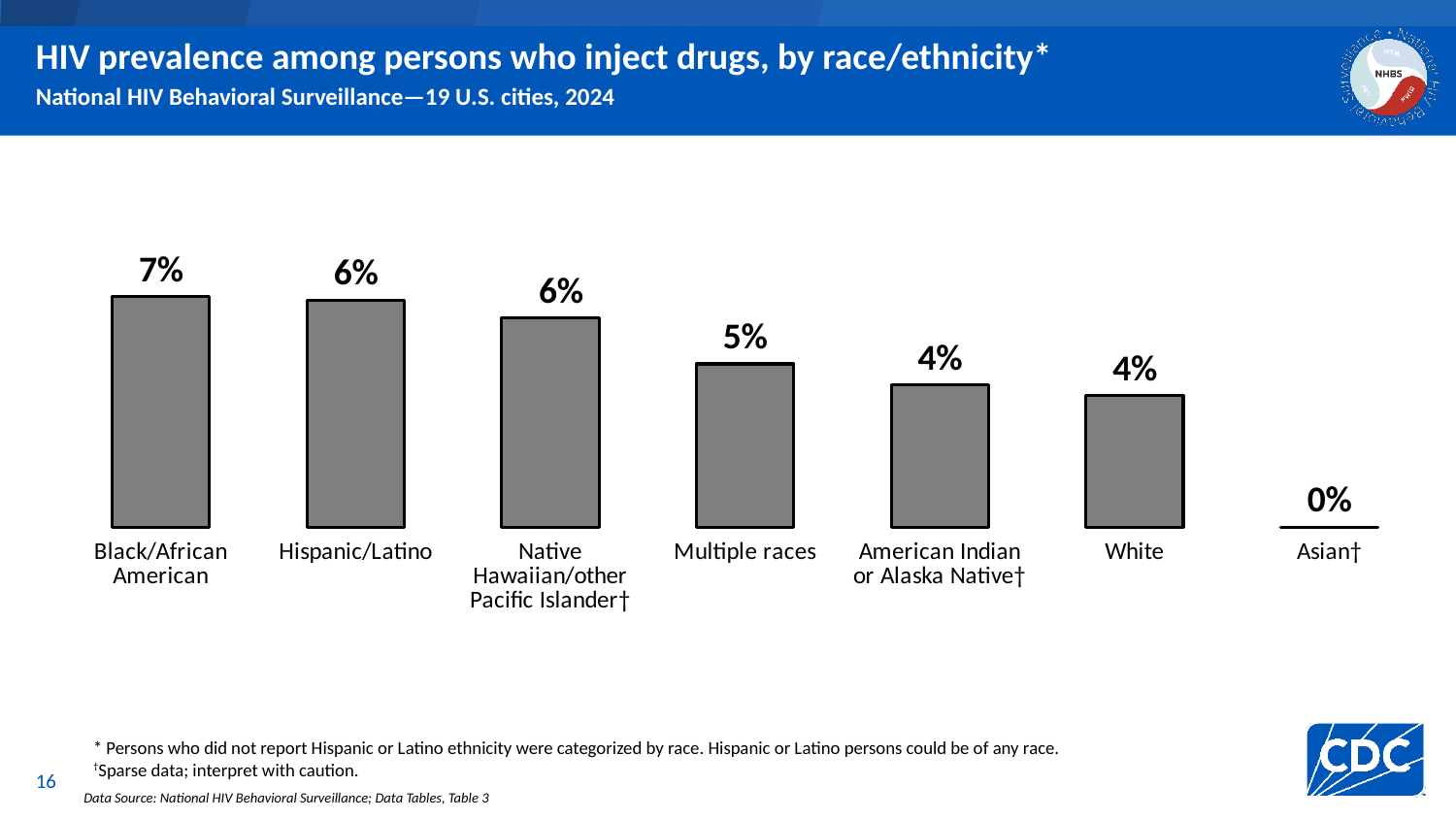
What is the difference in HIV prevalence between Black/African American and White persons who inject drugs? 3 percentage points What is the HIV prevalence for Black/African American persons who inject drugs? 7% What type of chart is shown on the slide? Bar chart What is the HIV prevalence for Multiple races? 5% What is the HIV prevalence for Hispanic/Latino persons who inject drugs? 6% Which race/ethnicity group has the lowest HIV prevalence? Asian Do the values generally rise or fall from left to right across the categories? Fall What is the HIV prevalence for White persons who inject drugs? 4% What is the HIV prevalence for Asian persons who inject drugs? 0% Which race/ethnicity group has the highest HIV prevalence? Black/African American How many race/ethnicity categories are shown in the chart? 7 Which has a higher HIV prevalence, Multiple races or American Indian or Alaska Native? Multiple races